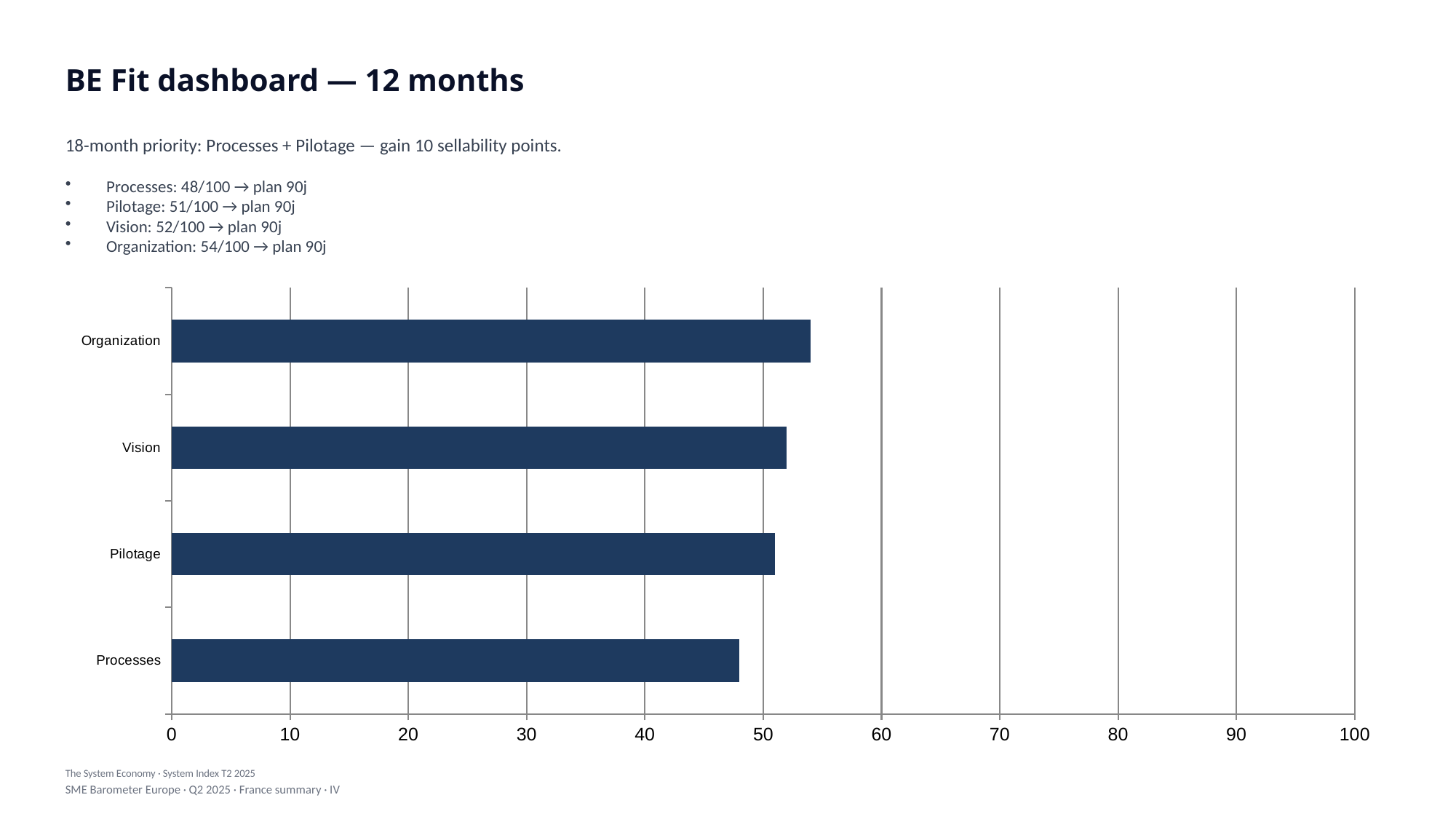
What is the maximum value shown on the horizontal axis? 100 Is the value for Organization greater or less than 50? greater What kind of chart is shown on the slide? bar chart How many categories does the chart show? 4 Which category has the highest value in the chart? Organization Is the value for Vision greater or less than 60? less Is the value for Processes greater or less than 50? less What is the score for Organization according to the slide? 54/100 Which category has the lowest value in the chart? Processes What is the difference between the Organization score and the Processes score? 6 What is the score for Processes according to the slide? 48/100 Which is larger, the value for Organization or the value for Processes? Organization